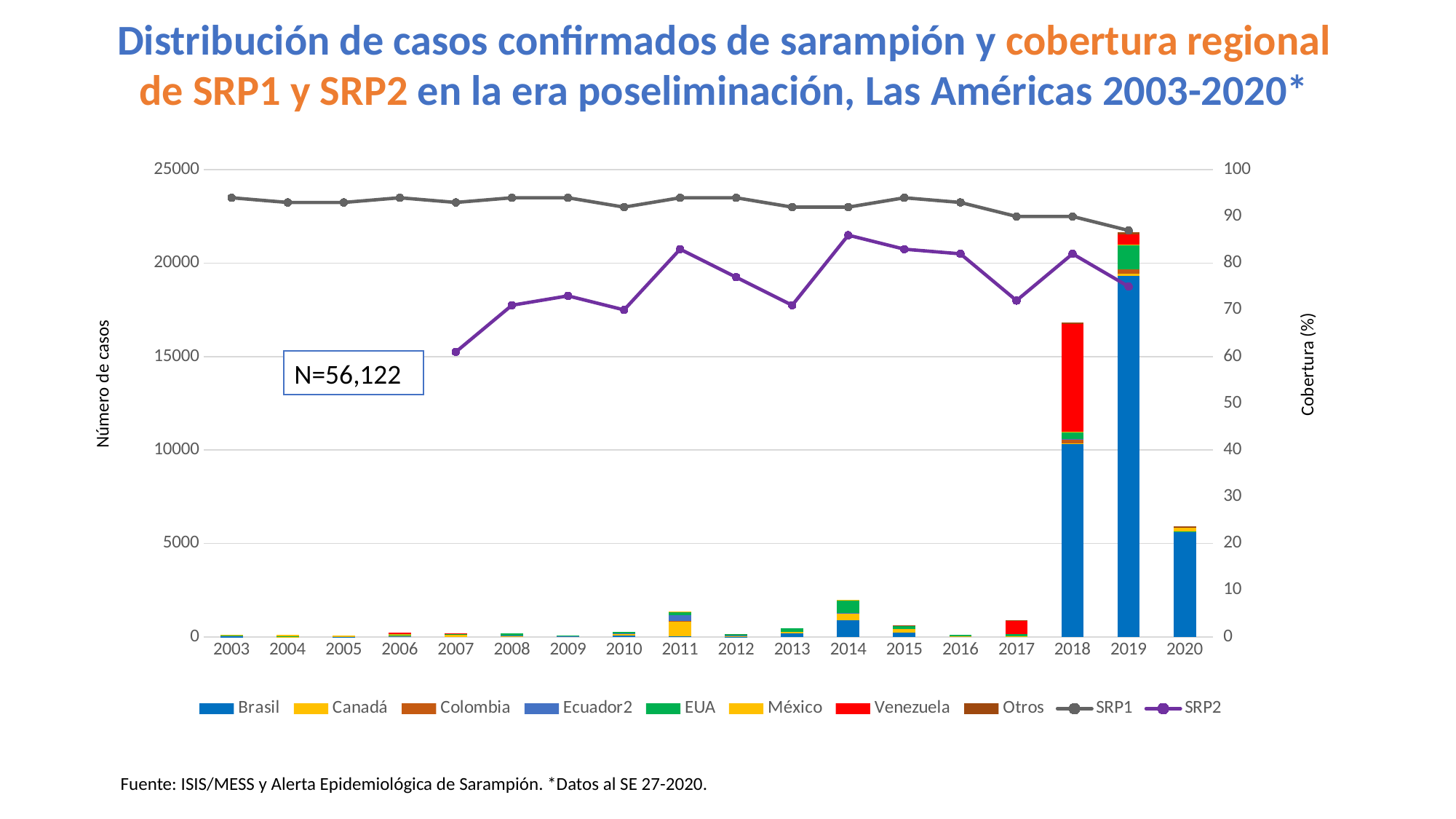
How many series does the chart's legend list? 10 Which country accounts for the largest part of the 2019 bar? Brasil In 2010, which line is higher, SRP1 or SRP2? SRP1 What total N is shown in the text box on the chart? N=56,122 How many years are shown along the x axis of the chart? 18 Which year has the highest total number of confirmed measles cases? 2019 Does the SRP1 coverage line rise or fall from 2015 to 2020? fall Is the SRP2 coverage in 2007 greater or less than 70? less Is the total number of cases in 2018 greater or less than 15000? greater Is the SRP1 coverage in 2003 greater or less than 90? greater What kind of chart is shown on the slide? A combined stacked bar and line chart